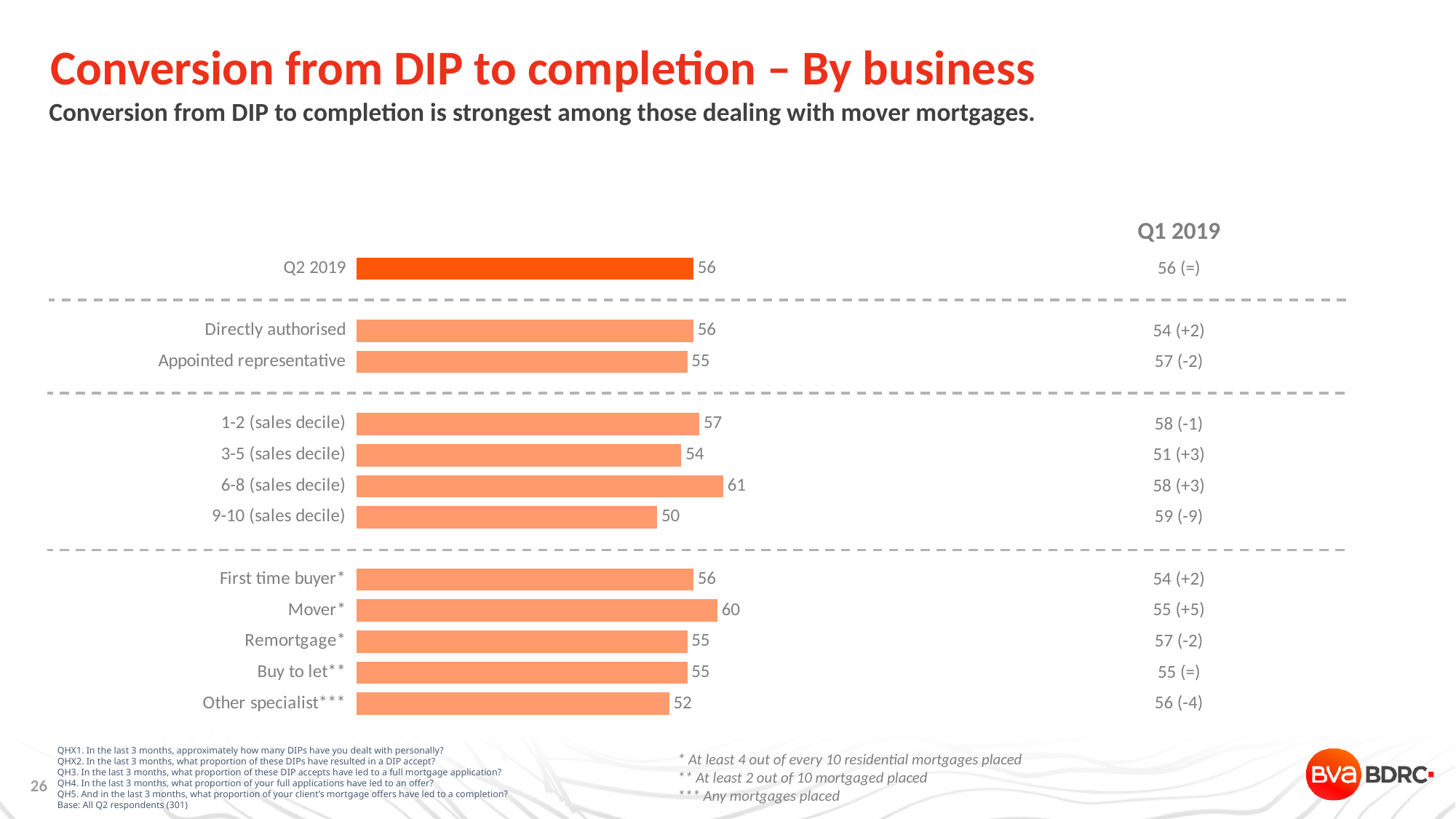
What is the value for 9-10 (sales decile)? 50 What kind of chart is shown? Bar chart What is the value for Q2 2019 overall? 56 What is the value for Mover*? 60 Which category has the lowest value? 9-10 (sales decile) What is the value for Other specialist***? 52 Which is larger, the value for Directly authorised or Appointed representative? Directly authorised What is the difference between the values for 6-8 (sales decile) and 9-10 (sales decile)? 11 Which category has the highest value? 6-8 (sales decile) What is the difference between the values for Mover* and First time buyer*? 4 How many bars are plotted on the chart? 12 What was the Q1 2019 value shown for 9-10 (sales decile)? 59 (-9)